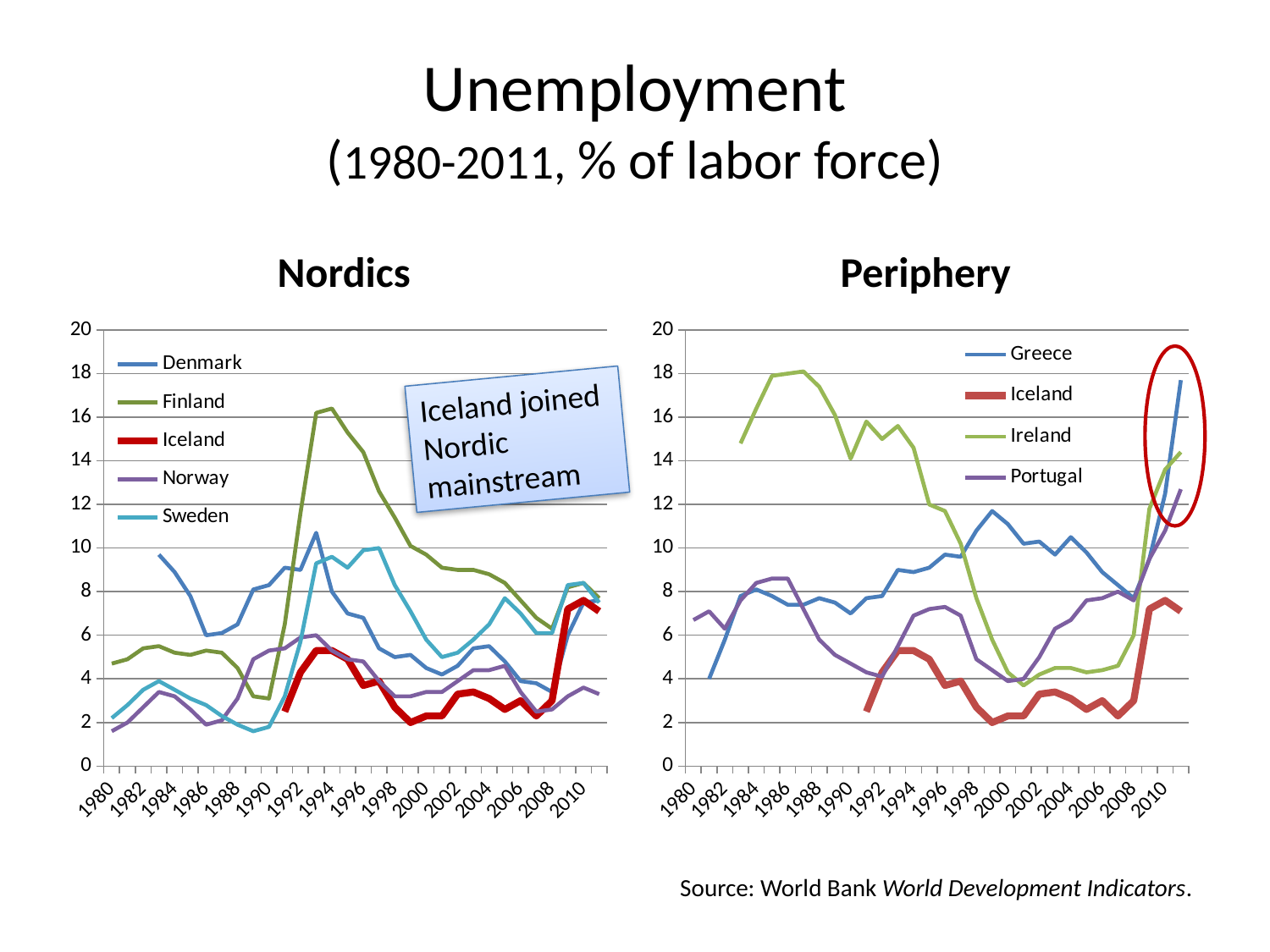
What kind of chart is the Nordics chart? line chart In the Periphery chart, which is larger in 2011, Greece or Portugal? Greece In the Nordics chart, which country reaches the highest unemployment rate at any point? Finland In the Periphery chart, does Greece's unemployment rate rise or fall from 2008 to 2011? rise In the Nordics chart, is Finland's value in 1994 greater or less than 14? greater In the Nordics chart, is Iceland's value in 2000 greater or less than 4? less In the Periphery chart, is Greece's value in 2011 greater or less than 14? greater How many series does the legend of the Nordics chart list? 5 What does the callout box on the Nordics chart say? Iceland joined Nordic mainstream In the Nordics chart, which country has the lowest unemployment rate in 2011? Norway How many series does the legend of the Periphery chart list? 4